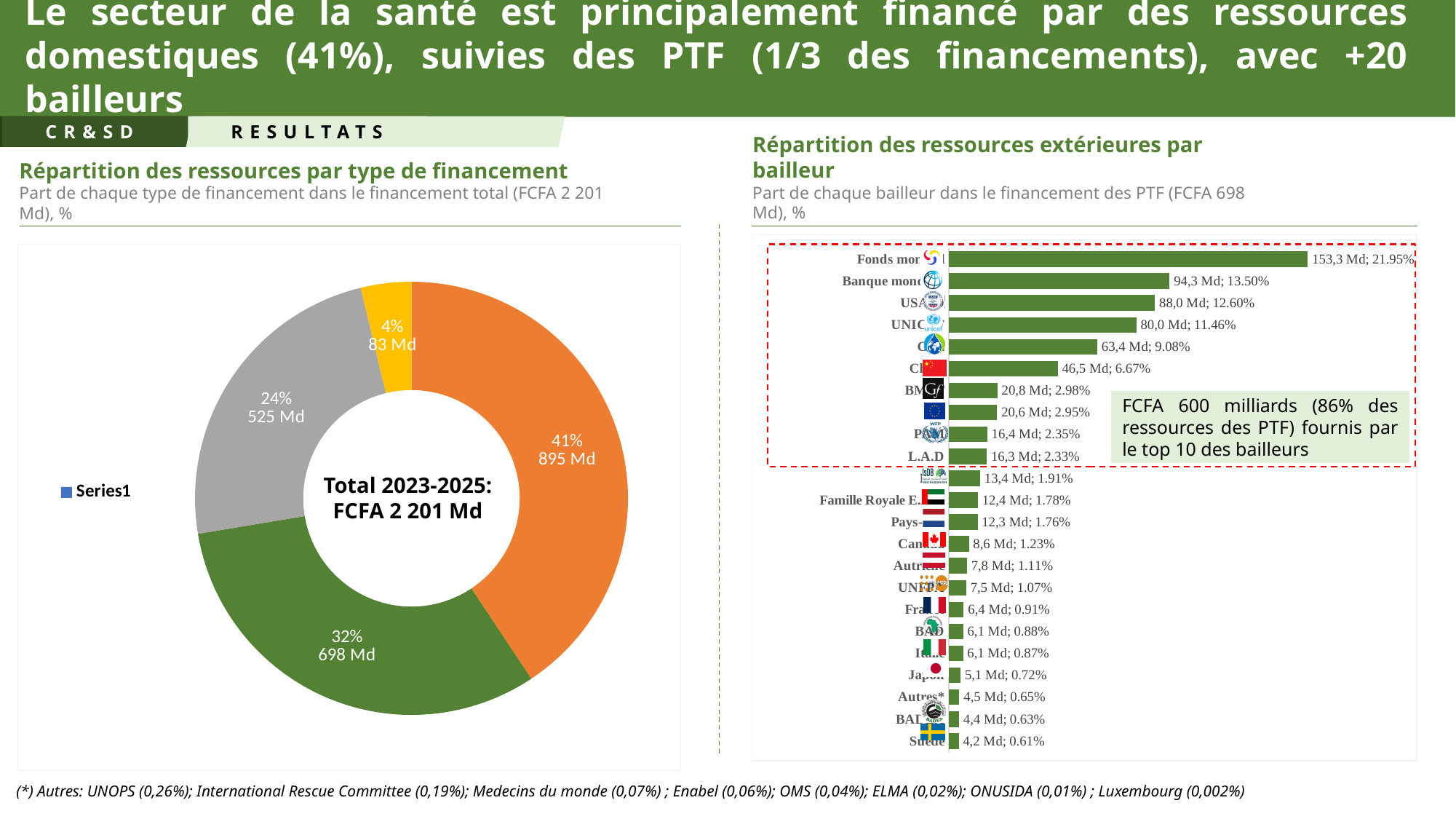
In the right bar chart, which has the larger value, Autriche or Japon? Autriche In the left pie chart, what amount is shown for the smallest slice? 83 Md What kind of chart is the left chart, 'Répartition des ressources par type de financement'? doughnut chart In the left pie chart, what total is written in the centre of the donut? Total 2023-2025: FCFA 2 201 Md What kind of chart is the right chart, 'Répartition des ressources extérieures par bailleur'? bar chart In the left pie chart, how many slices are there? 4 In the right bar chart, what is the largest value shown? 153,3 Md; 21.95% In the left pie chart, what percentage does the largest slice represent? 41% In the right bar chart, what percentage is shown for USA? 12.60% In the right bar chart, what is the difference in Md between Banque mondiale (94,3 Md) and USA (88,0 Md)? 6,3 Md In the left pie chart, what is the difference between the 41% slice (895 Md) and the 32% slice (698 Md)? 197 Md In the right bar chart, what amount is shown for Suède? 4,2 Md